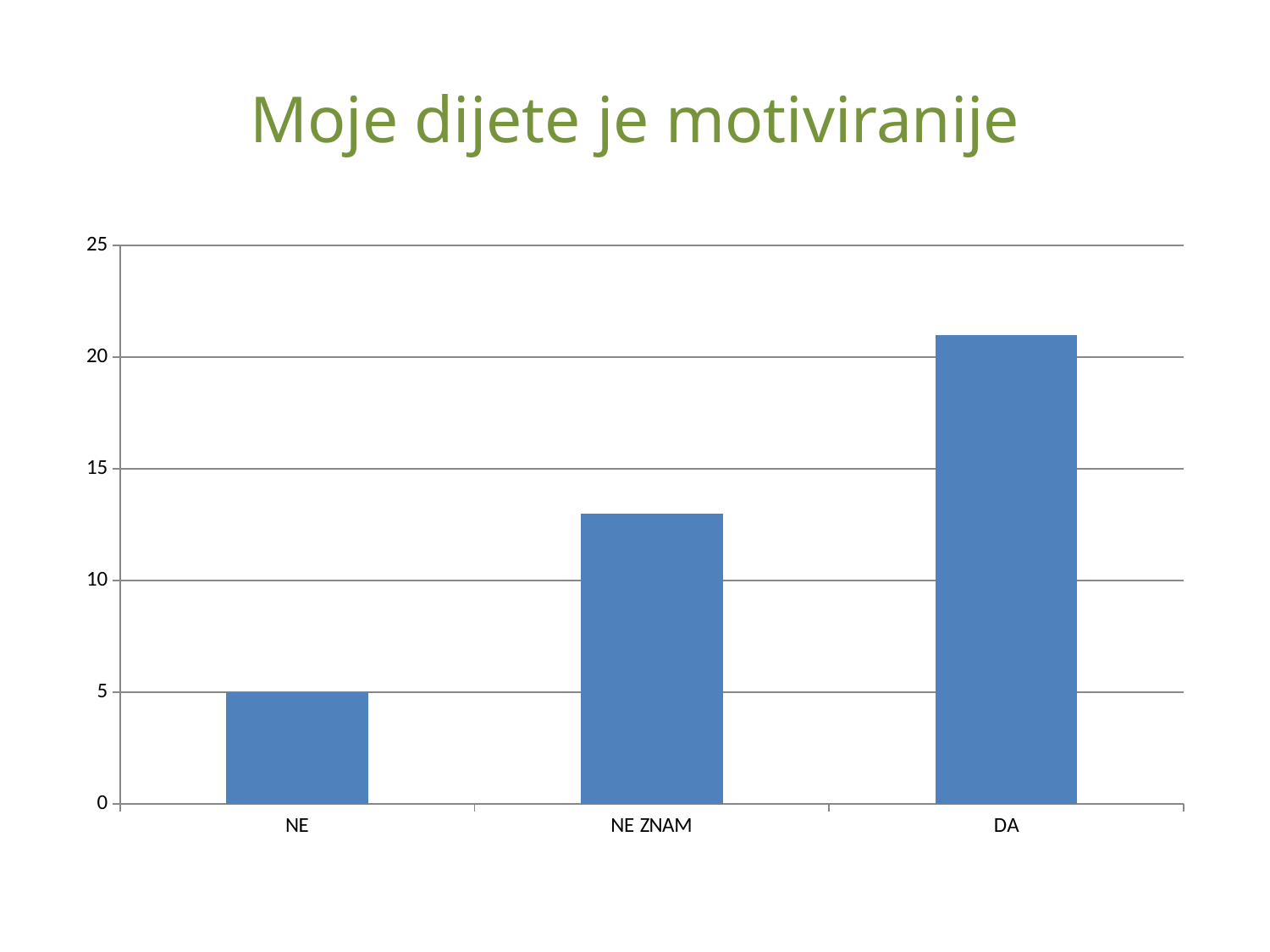
What is the value for NE? 5 Which category has the highest bar? DA What is the title of the slide? Moje dijete je motiviranije Do the values rise or fall from left to right along the x axis? rise What kind of chart is shown on the slide? bar chart Is the value for NE ZNAM greater or less than 15? less Is the value for DA greater or less than 25? less Which category has the lowest bar? NE Is the value for DA greater or less than 20? greater Which is larger, the value for NE ZNAM or the value for DA? DA How many categories are shown on the x axis of the chart? 3